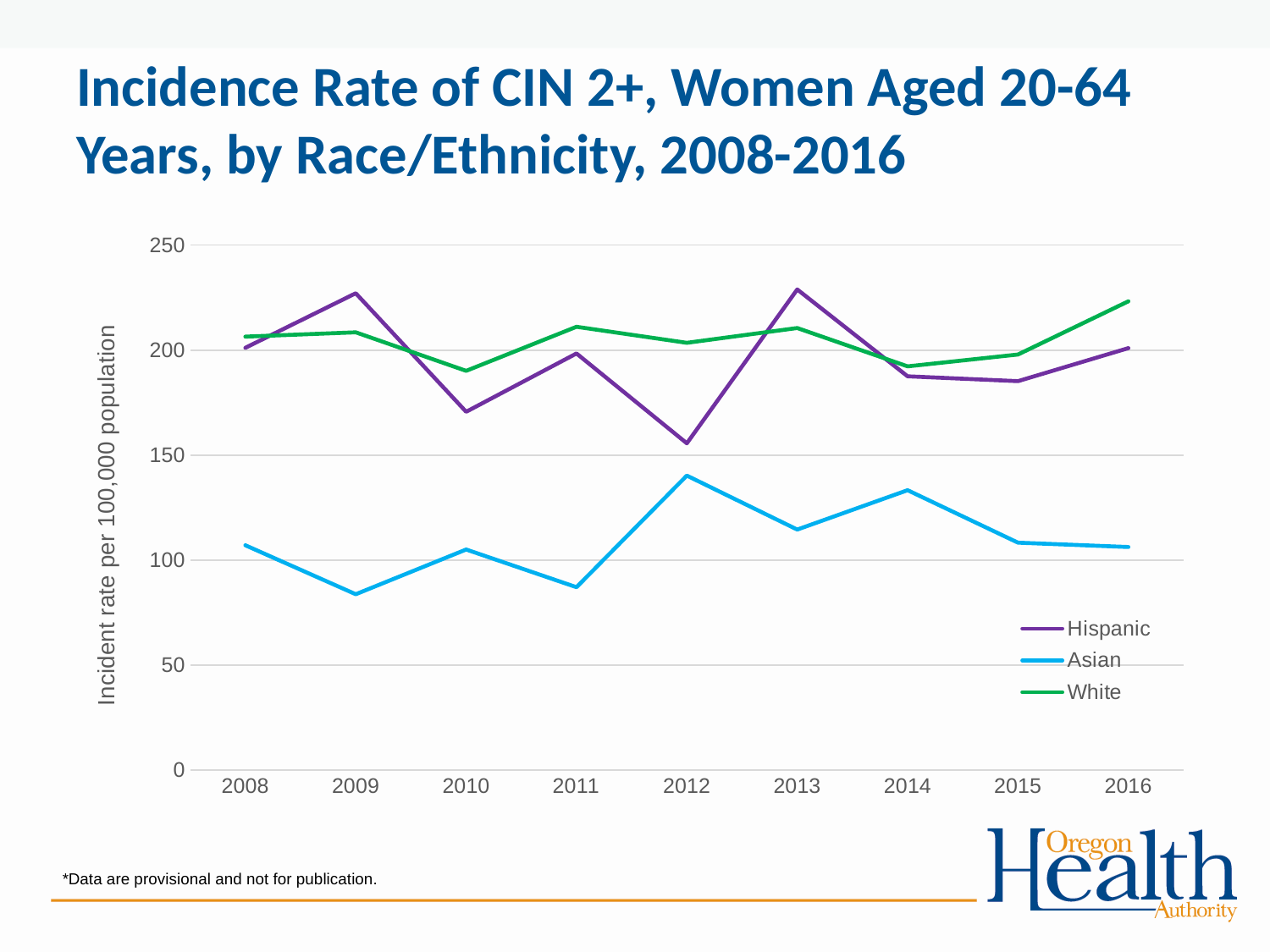
How many series does the legend list? 3 Does the White line rise or fall from 2014 to 2016? rise Is the Hispanic value for 2013 greater or less than 200? greater Is the Asian value for 2009 greater or less than 100? less In which year is the White incidence rate highest? 2016 Is the Asian value for 2012 greater or less than 150? less What kind of chart is shown on the slide? line chart In which year is the Hispanic incidence rate lowest? 2012 What is the label on the y axis? Incident rate per 100,000 population Which series is lowest in every year shown? Asian How many years are plotted along the x axis? 9 Which is larger in 2012, the Hispanic value or the White value? White